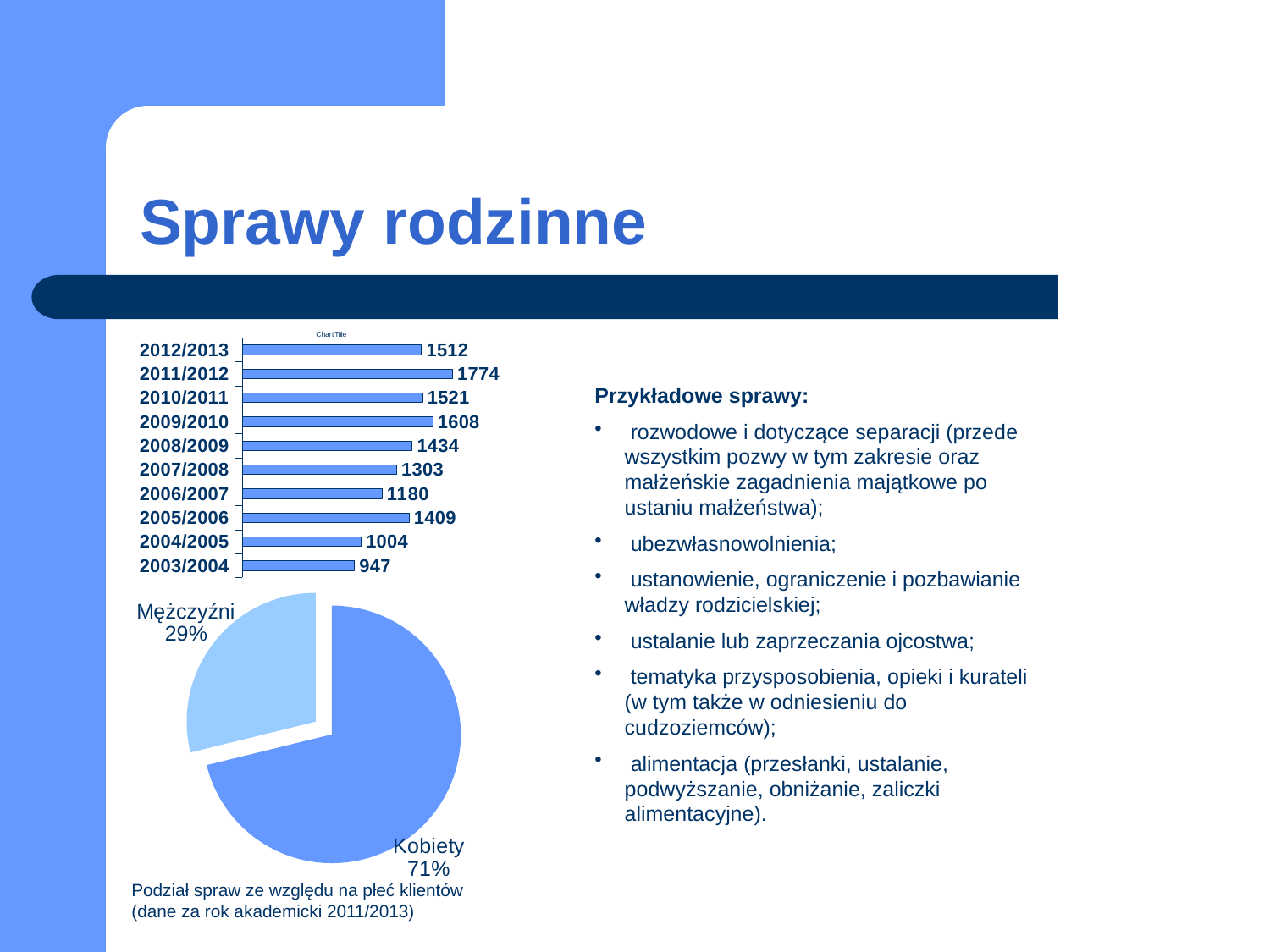
In the bar chart at the top left, which is larger, the value for 2009/2010 or the value for 2010/2011? 2009/2010 What kind of chart is the chart at the top left of the slide? Bar chart In the bar chart at the top left, how many academic years are shown? 10 In the pie chart at the bottom left, what share is labelled Kobiety? 71% In the bar chart at the top left, what is the value for 2006/2007? 1180 In the bar chart at the top left, what is the value for 2003/2004? 947 In the pie chart at the bottom left, what share is labelled Mężczyźni? 29% In the bar chart at the top left, what is the difference between the values for 2011/2012 and 2012/2013? 262 In the bar chart at the top left, which academic year has the lowest value? 2003/2004 What kind of chart is the chart at the bottom left of the slide? Pie chart In the bar chart at the top left, which academic year has the highest value? 2011/2012 In the bar chart at the top left, what is the value for 2011/2012? 1774